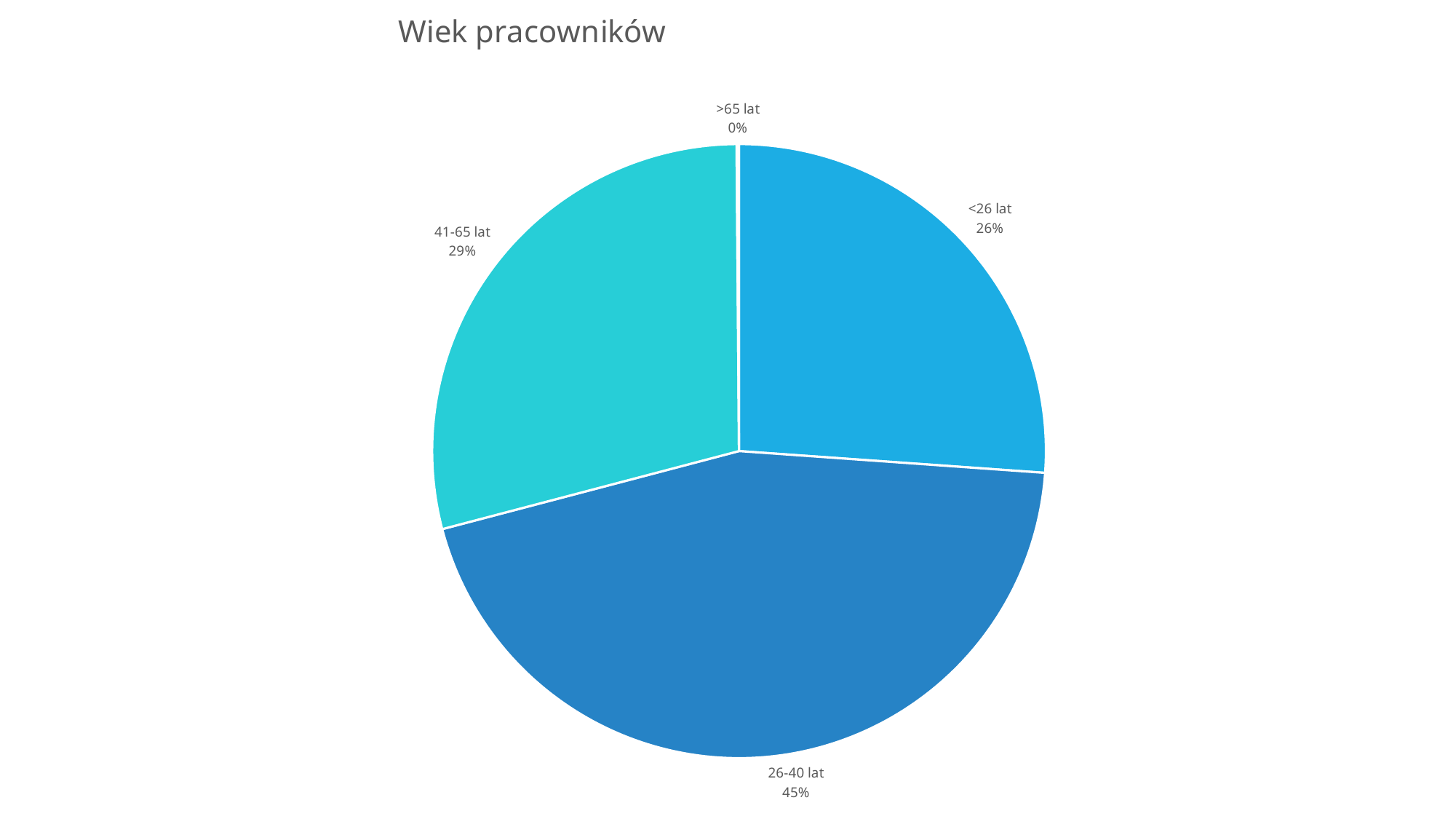
How many age categories are labelled on the pie chart? 4 What type of chart is shown on the slide? pie chart Which age group has the smallest share of the pie? >65 lat What is the difference in percentage points between the 26-40 lat slice and the <26 lat slice? 19 What is the value shown for the 41-65 lat slice? 29% Which age group has the largest share of the pie? 26-40 lat Which slice is larger, 41-65 lat or <26 lat? 41-65 lat What is the title of the chart? Wiek pracowników What is the combined share of the 41-65 lat and <26 lat slices? 55% What is the value shown for the <26 lat slice? 26% What is the value shown for the >65 lat slice? 0% What share of the pie does the 26-40 lat slice represent? 45%